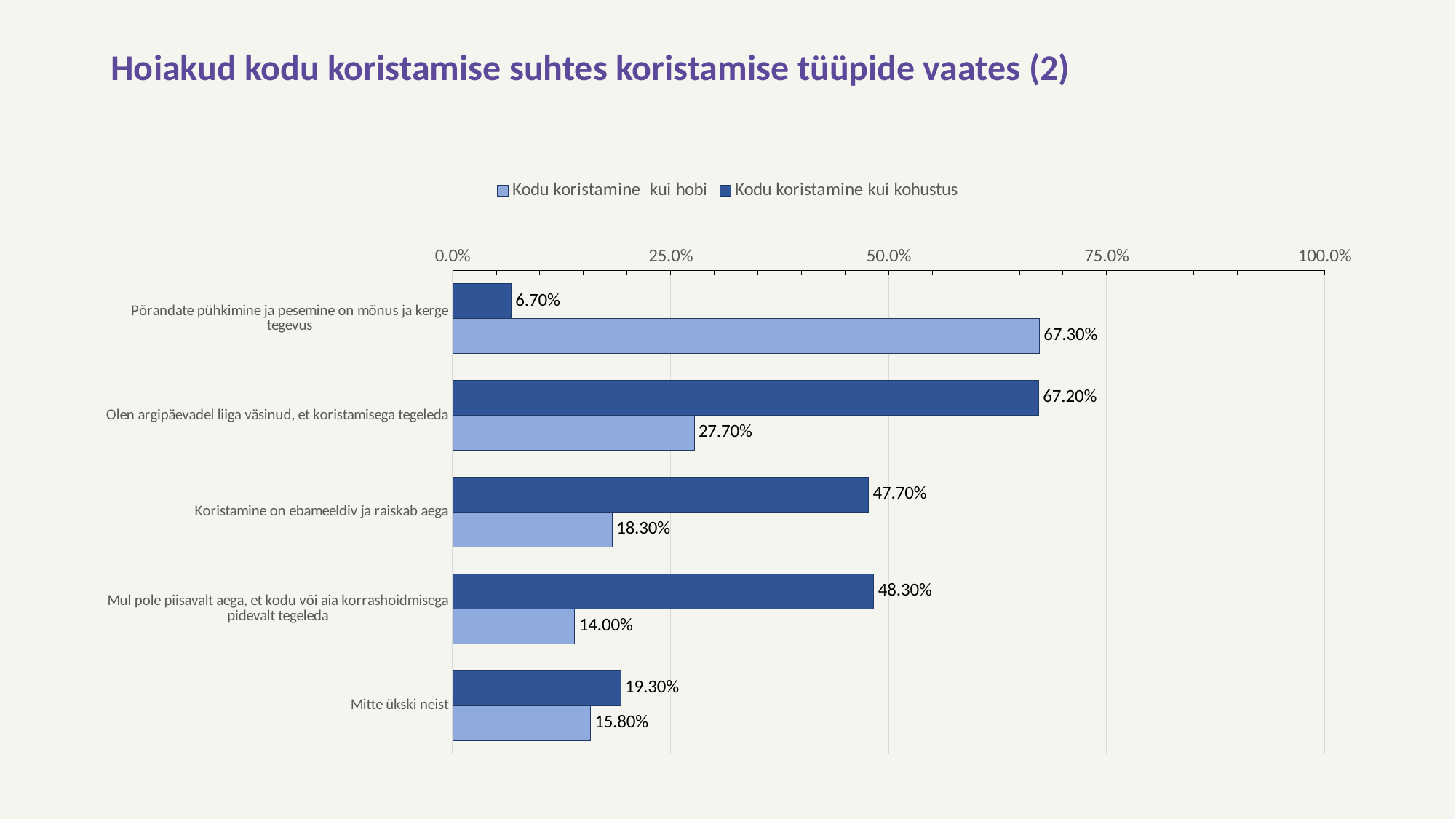
How many categories are shown on the chart? 5 What is the value for "Kodu koristamine kui hobi" for "Põrandate pühkimine ja pesemine on mõnus ja kerge tegevus"? 67.30% Which category has the highest value for "Kodu koristamine kui kohustus"? Olen argipäevadel liiga väsinud, et koristamisega tegeleda What is the title of the slide? Hoiakud kodu koristamise suhtes koristamise tüüpide vaates (2) What is the difference between the "Kodu koristamine kui kohustus" and "Kodu koristamine kui hobi" values for "Koristamine on ebameeldiv ja raiskab aega"? 29.40% Which category has the lowest value for "Kodu koristamine kui hobi"? Mul pole piisavalt aega, et kodu või aia korrashoidmisega pidevalt tegeleda Is the "Kodu koristamine kui kohustus" value for "Mul pole piisavalt aega, et kodu või aia korrashoidmisega pidevalt tegeleda" greater or less than 25.0%? greater What is the value for "Kodu koristamine kui kohustus" for "Olen argipäevadel liiga väsinud, et koristamisega tegeleda"? 67.20% How many series does the legend list? 2 What is the value for "Kodu koristamine kui hobi" for "Mitte ükski neist"? 15.80% For "Mitte ükski neist", which series has the larger value? Kodu koristamine kui kohustus What kind of chart is shown on the slide? Bar chart